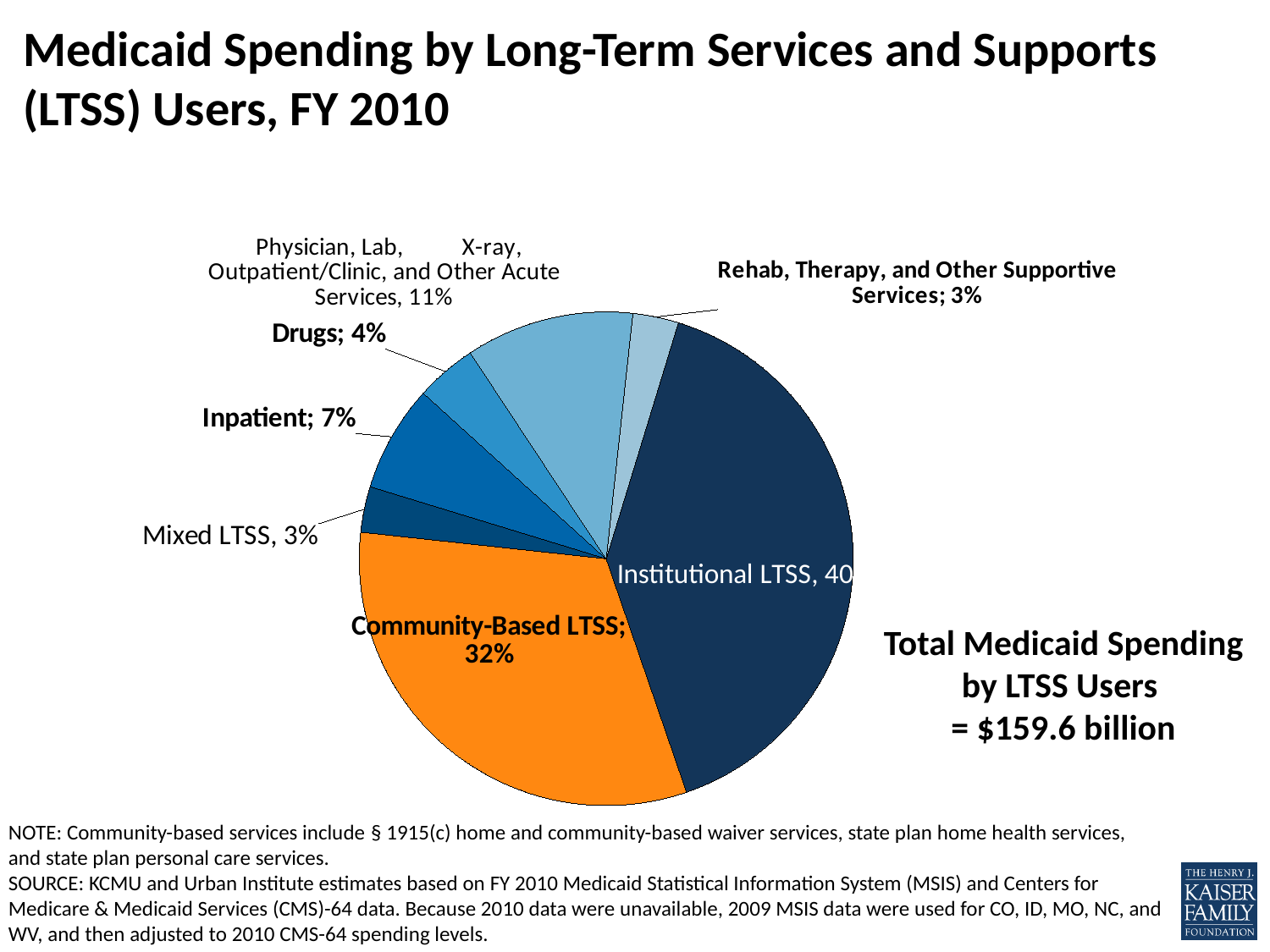
What share of Medicaid spending by LTSS users goes to Community-Based LTSS? 32% What percentage of spending is for Inpatient services? 7% What share of spending goes to Physician, Lab, X-ray, Outpatient/Clinic, and Other Acute Services? 11% What share of spending goes to Rehab, Therapy, and Other Supportive Services? 3% How many percentage points larger is the Community-Based LTSS share than the Inpatient share? 25 percentage points How many slices does the pie chart have? 7 What is the total Medicaid spending by LTSS users stated on the slide? $159.6 billion Which is larger, the share for Inpatient or the share for Drugs? Inpatient Which category accounts for the largest share of Medicaid spending by LTSS users? Institutional LTSS What percentage of spending is for Drugs? 4% What type of chart is shown on the slide? pie chart What percentage of spending is for Mixed LTSS? 3%